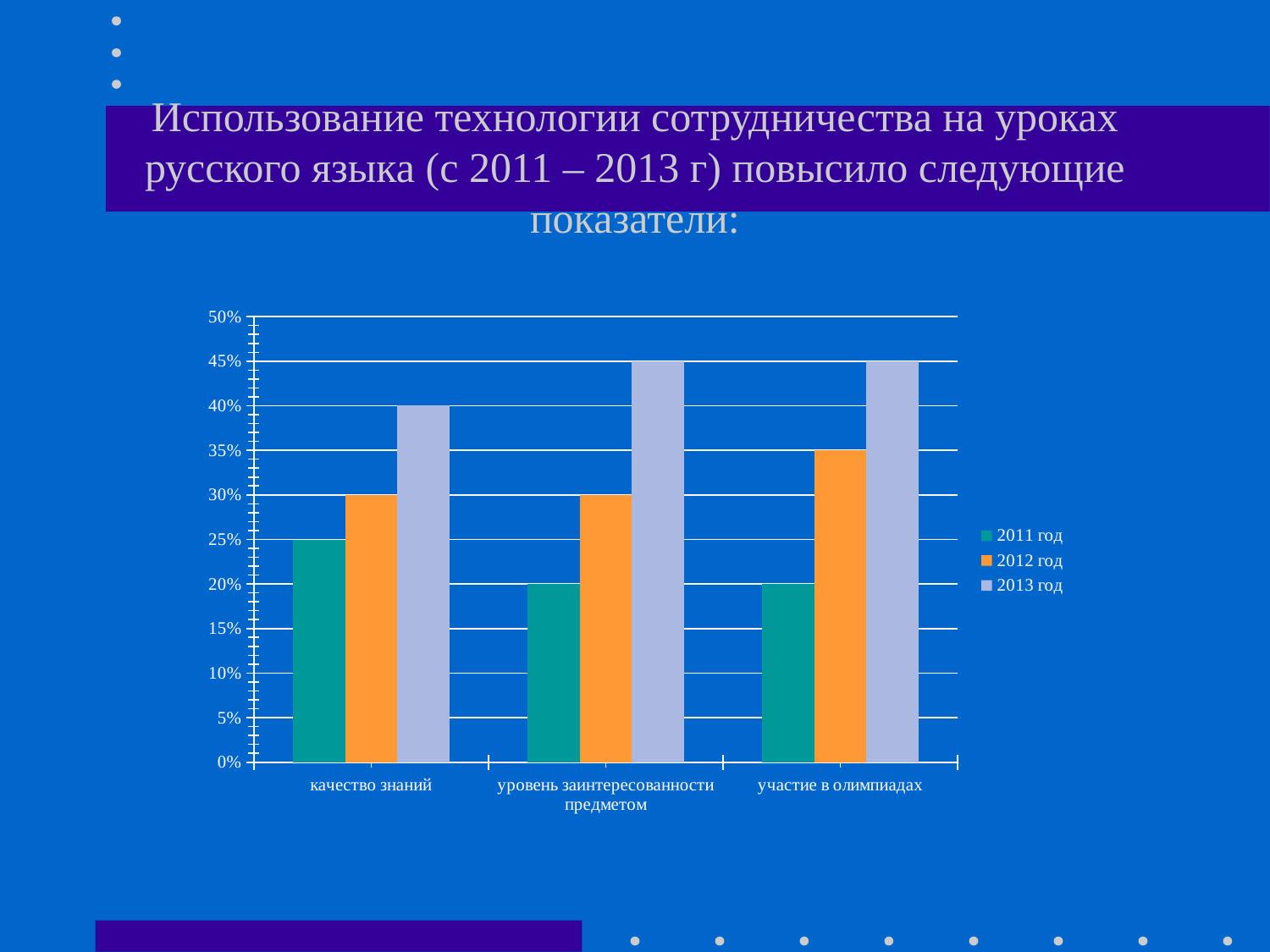
How many categories are shown on the x axis? 3 What kind of chart is shown on the slide? bar chart Which is larger in the category уровень заинтересованности предметом: the value for 2012 год or for 2011 год? 2012 год What is the value for 2011 год in the category качество знаний? 25% Which category has the lowest value for 2013 год? качество знаний What is the value for 2012 год in the category участие в олимпиадах? 35% Which series is shown in orange in the legend? 2012 год What is the value for 2013 год in the category уровень заинтересованности предметом? 45% What is the value for 2013 год in the category качество знаний? 40% Which category has the highest value for 2011 год? качество знаний What is the difference between the 2013 год and 2011 год values in the category участие в олимпиадах? 25% How many series does the legend list? 3